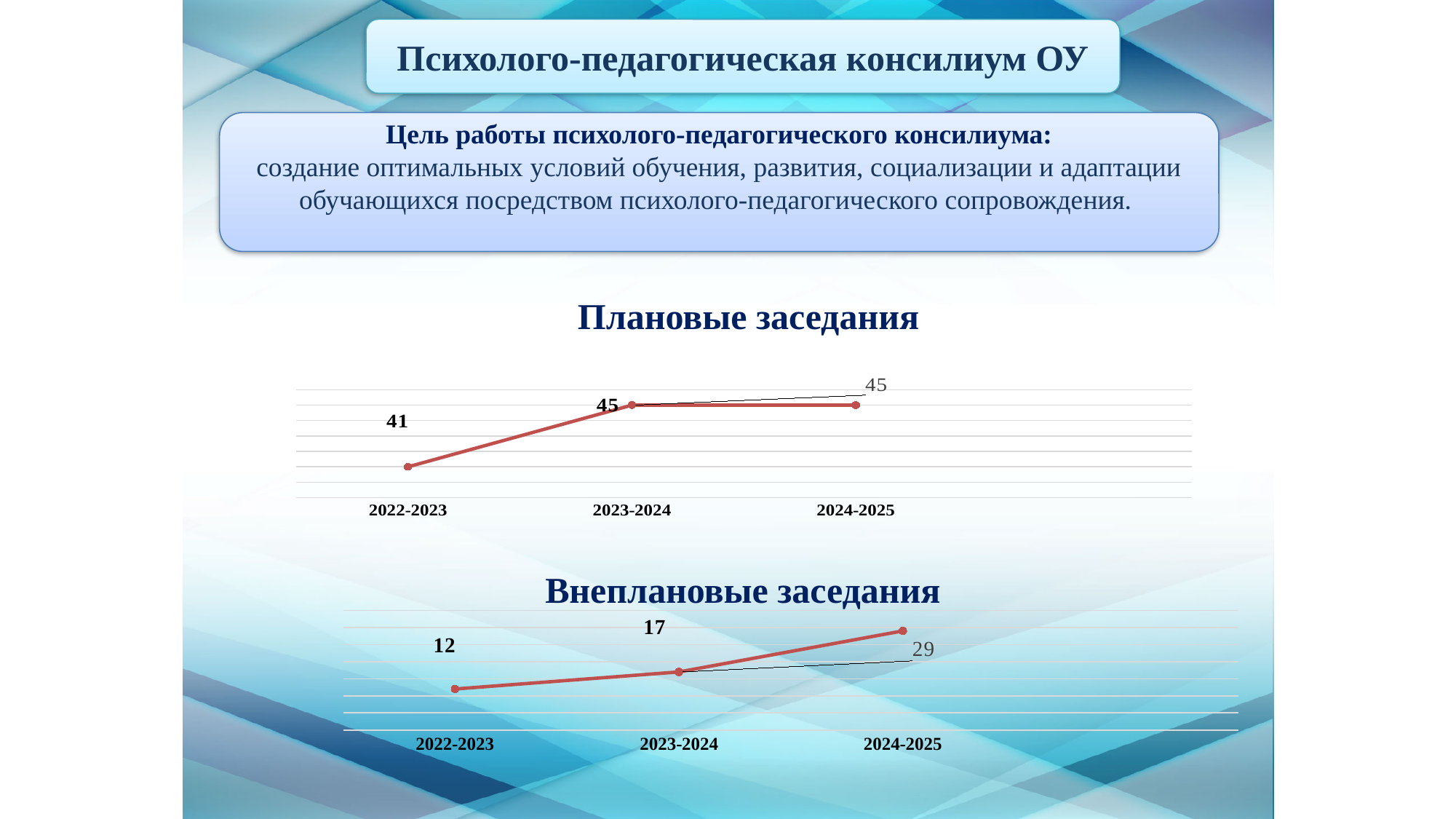
In the 'Внеплановые заседания' chart, do the values rise or fall from 2022-2023 to 2024-2025? rise In the 'Внеплановые заседания' chart, which period has the highest value? 2024-2025 In the 'Плановые заседания' chart, what is the value for 2023-2024? 45 In the 'Плановые заседания' chart, what is the value for 2022-2023? 41 In the 'Внеплановые заседания' chart, what is the difference between the values for 2024-2025 and 2023-2024? 12 In the 'Плановые заседания' chart, which period has the lowest value? 2022-2023 In the 'Плановые заседания' chart, what is the difference between the values for 2023-2024 and 2022-2023? 4 In the 'Внеплановые заседания' chart, what is the value for 2022-2023? 12 In the 'Внеплановые заседания' chart, which is larger: the value for 2023-2024 or 2022-2023? 2023-2024 How many periods are shown on the x axis of the 'Плановые заседания' chart? 3 What kind of chart is the 'Внеплановые заседания' chart? line chart In the 'Внеплановые заседания' chart, what is the value for 2024-2025? 29